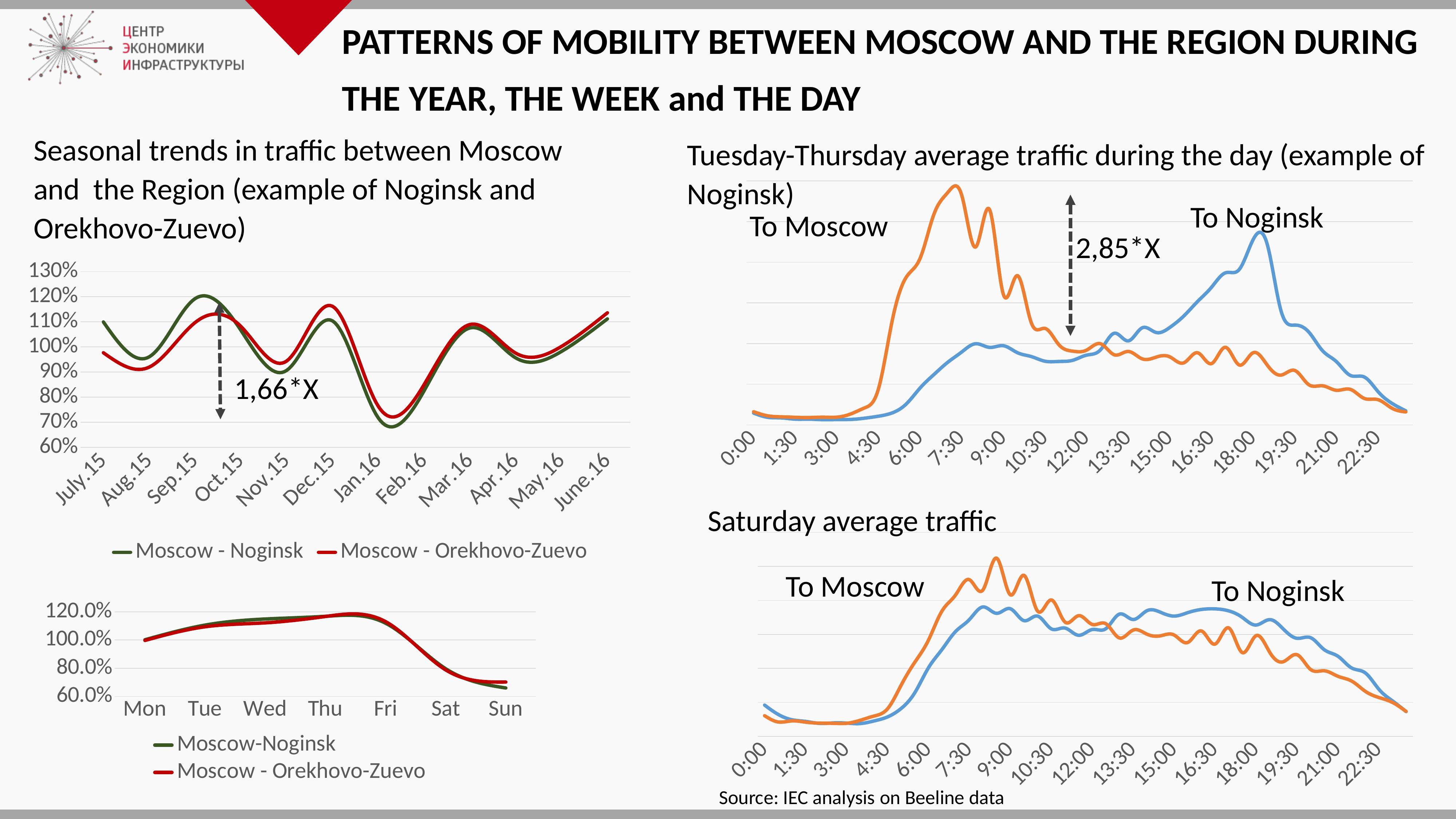
How many days of the week are shown on the x axis of the weekly chart (bottom-left)? 7 How many series does the legend of the seasonal trends chart (top-left) list? 2 In the seasonal trends chart (top-left), which series is higher in Sep.15: Moscow - Noginsk or Moscow - Orekhovo-Zuevo? Moscow - Noginsk In the weekly chart (bottom-left), on which day is the Moscow-Noginsk series lowest? Sun What ratio is annotated with the dashed arrow on the seasonal trends chart (top-left)? 1,66*X In the 'Tuesday-Thursday average traffic during the day' chart, which series reaches its peak earlier in the day: To Moscow or To Noginsk? To Moscow In the seasonal trends chart (top-left), is the Moscow - Noginsk value for Sep.15 greater or less than 110%? greater How many months are shown on the x axis of the seasonal trends chart (top-left)? 12 In the seasonal trends chart (top-left), in which month is the Moscow - Noginsk series lowest? Jan.16 In the seasonal trends chart (top-left), is the Moscow - Noginsk value for Jan.16 greater or less than 80%? less What kind of chart is the 'Seasonal trends in traffic between Moscow and the Region' chart? Line chart